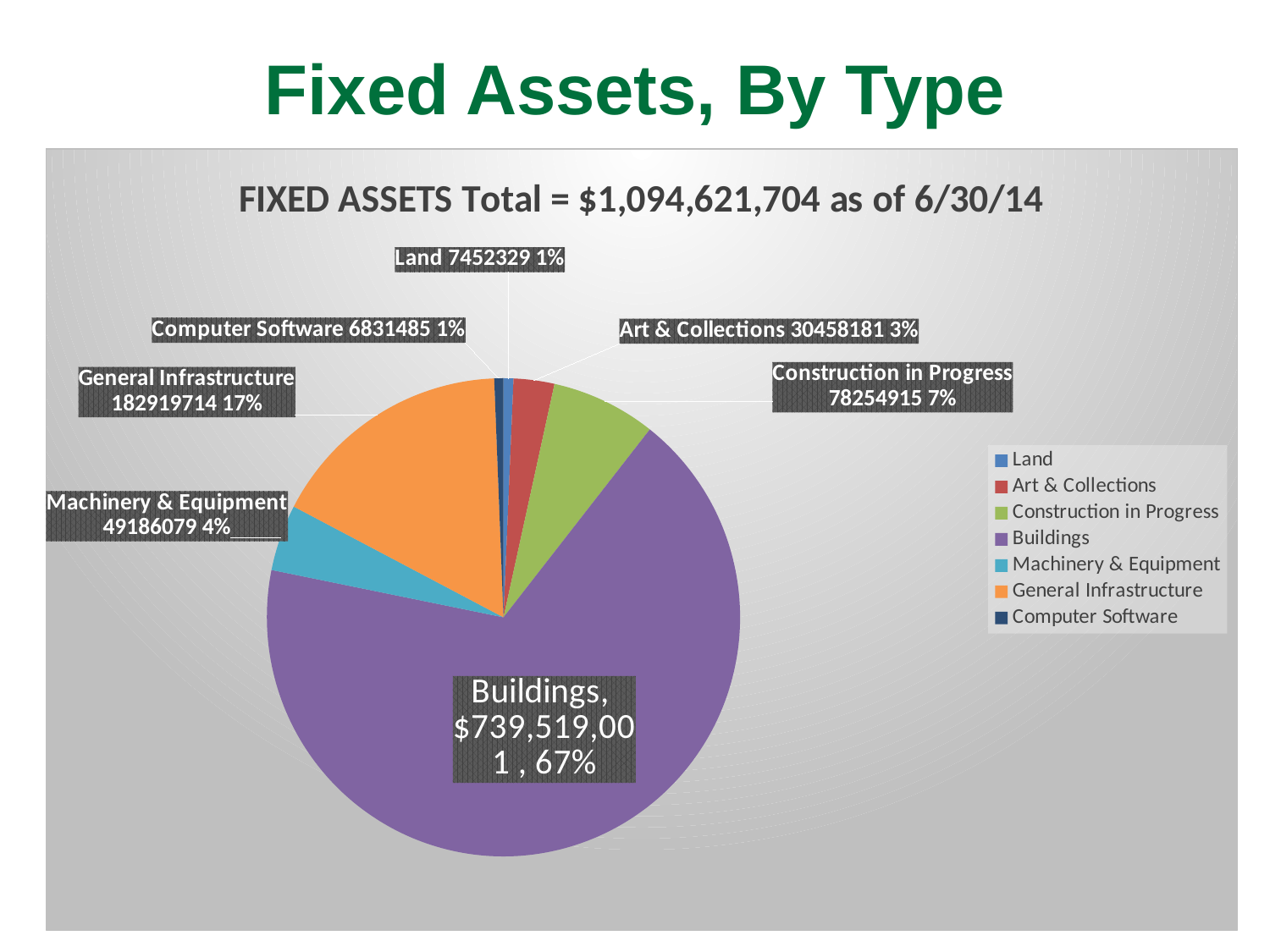
What total is stated in the chart title? $1,094,621,704 What kind of chart is shown on the slide? pie chart What is the difference between the values for General Infrastructure and Machinery & Equipment? 133733635 Which is larger, Construction in Progress or Art & Collections? Construction in Progress What is the value shown for Machinery & Equipment? 49186079 What is the value shown for Construction in Progress? 78254915 Which category has the smallest value in the pie chart? Computer Software What share of the pie does Buildings represent? 67% What share of the pie does General Infrastructure represent? 17% How many categories does the pie chart have? 7 Which category has the largest slice of the pie? Buildings What is the value shown for General Infrastructure? 182919714